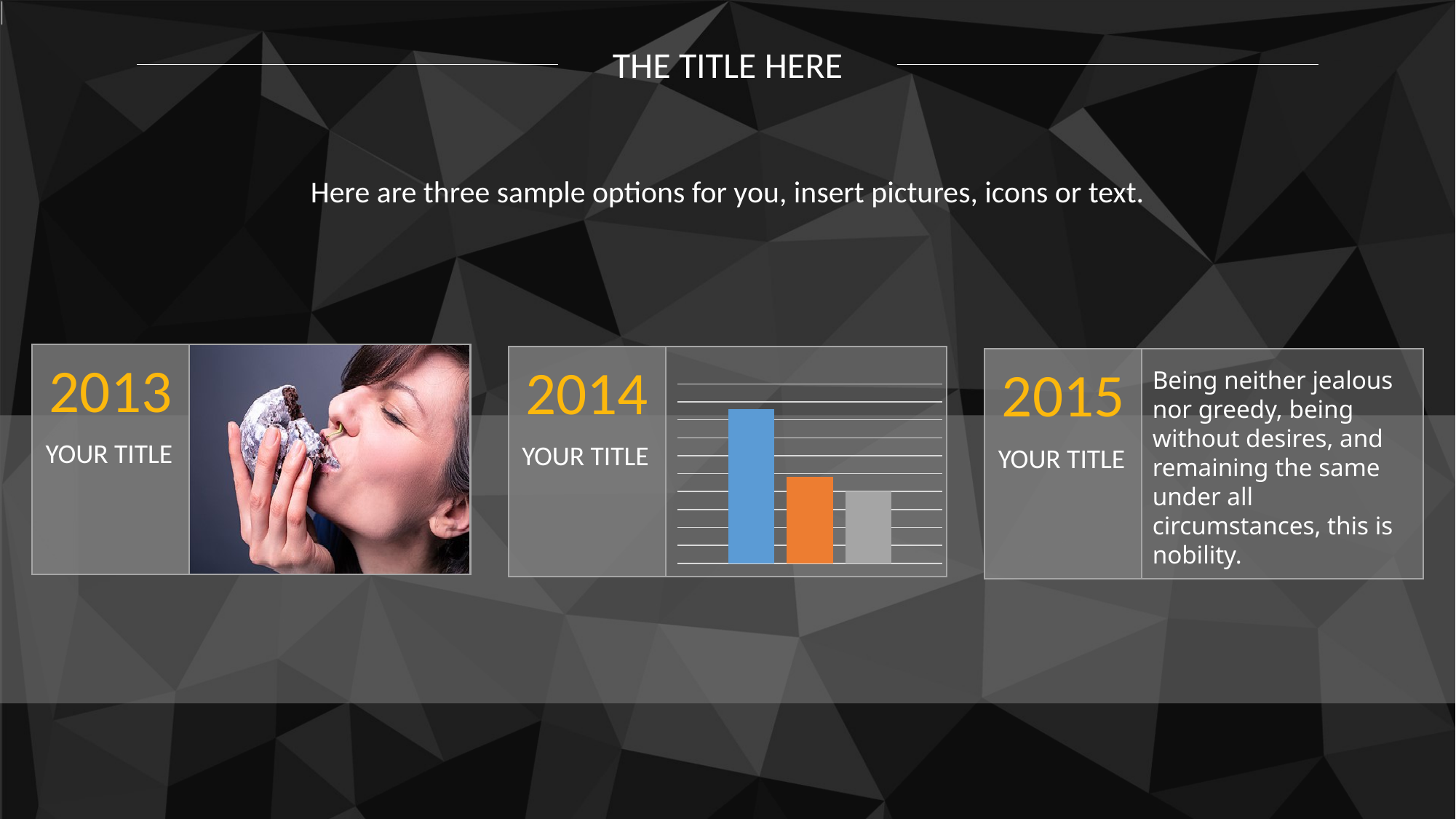
In the chart in the 2014 panel, which bar is the shortest? the gray bar Does the chart in the 2014 panel show a legend? No What colours are the three bars in the chart in the 2014 panel, from left to right? blue, orange, gray In the chart in the 2014 panel, which bar is the tallest? the blue bar What kind of chart is shown in the 2014 panel? bar chart In the chart in the 2014 panel, do the bar heights rise or fall from left to right? fall In the chart in the 2014 panel, is the orange bar taller or shorter than the blue bar? shorter How many bars are plotted in the chart in the 2014 panel? 3 In the chart in the 2014 panel, is the orange bar taller or shorter than the gray bar? taller